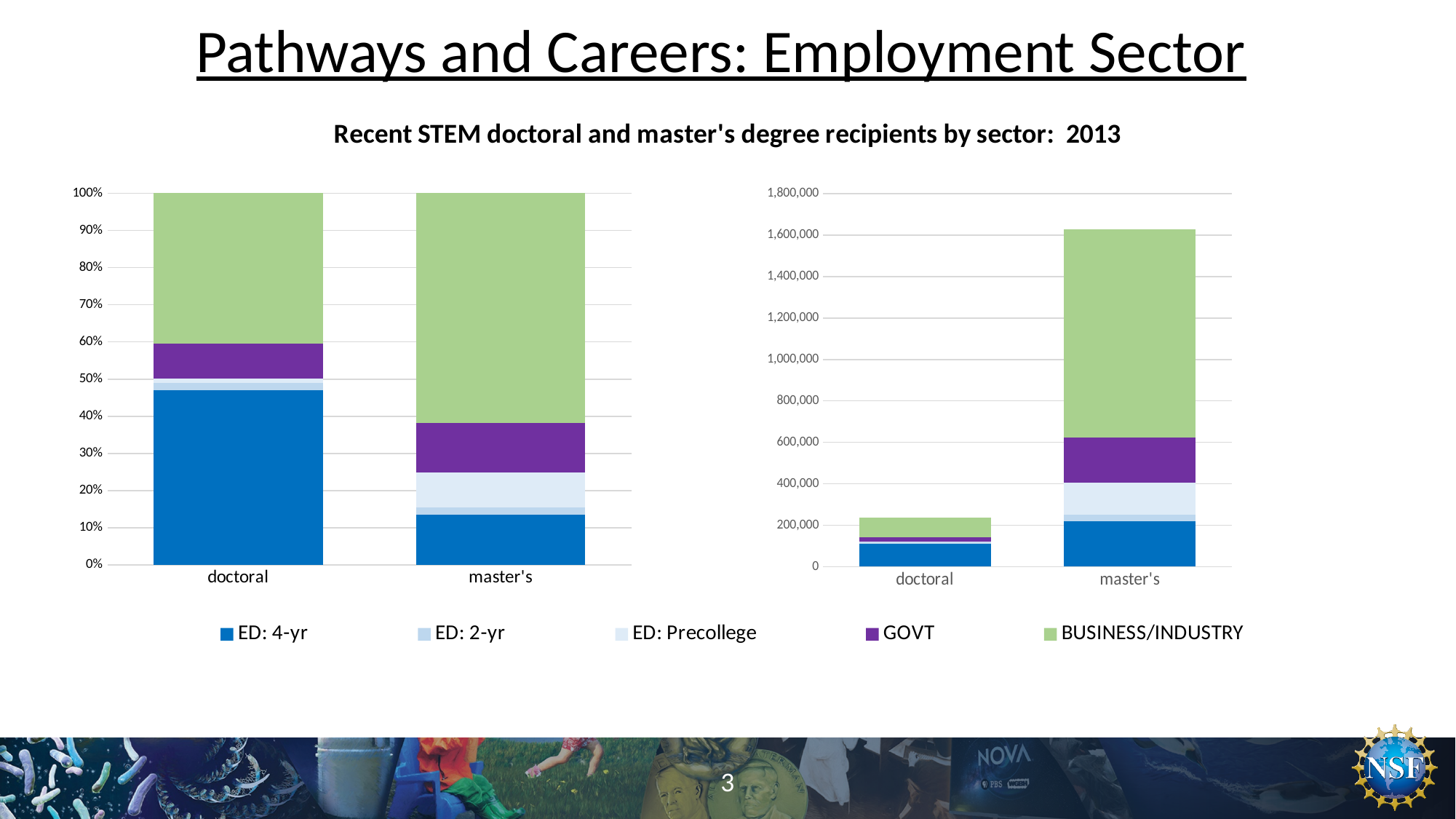
How many categories are shown on the x axis of the right chart? 2 In the left (percentage) chart, which category has the larger ED: 4-yr share, doctoral or master's? doctoral Which colour represents BUSINESS/INDUSTRY in the legend? green What kind of chart is the left chart on the slide? bar chart In the right chart, which category has the taller stacked bar, doctoral or master's? master's In the right chart, is the total height of the doctoral bar greater or less than 400,000? less How many series does the legend list? 5 What is the title shown above the charts? Recent STEM doctoral and master's degree recipients by sector: 2013 In the left (percentage) chart, is the ED: 4-yr share for master's greater or less than 20%? less In the left (percentage) chart, is the ED: 4-yr share for doctoral greater or less than 40%? greater In the left (percentage) chart, which category has the larger BUSINESS/INDUSTRY share, doctoral or master's? master's